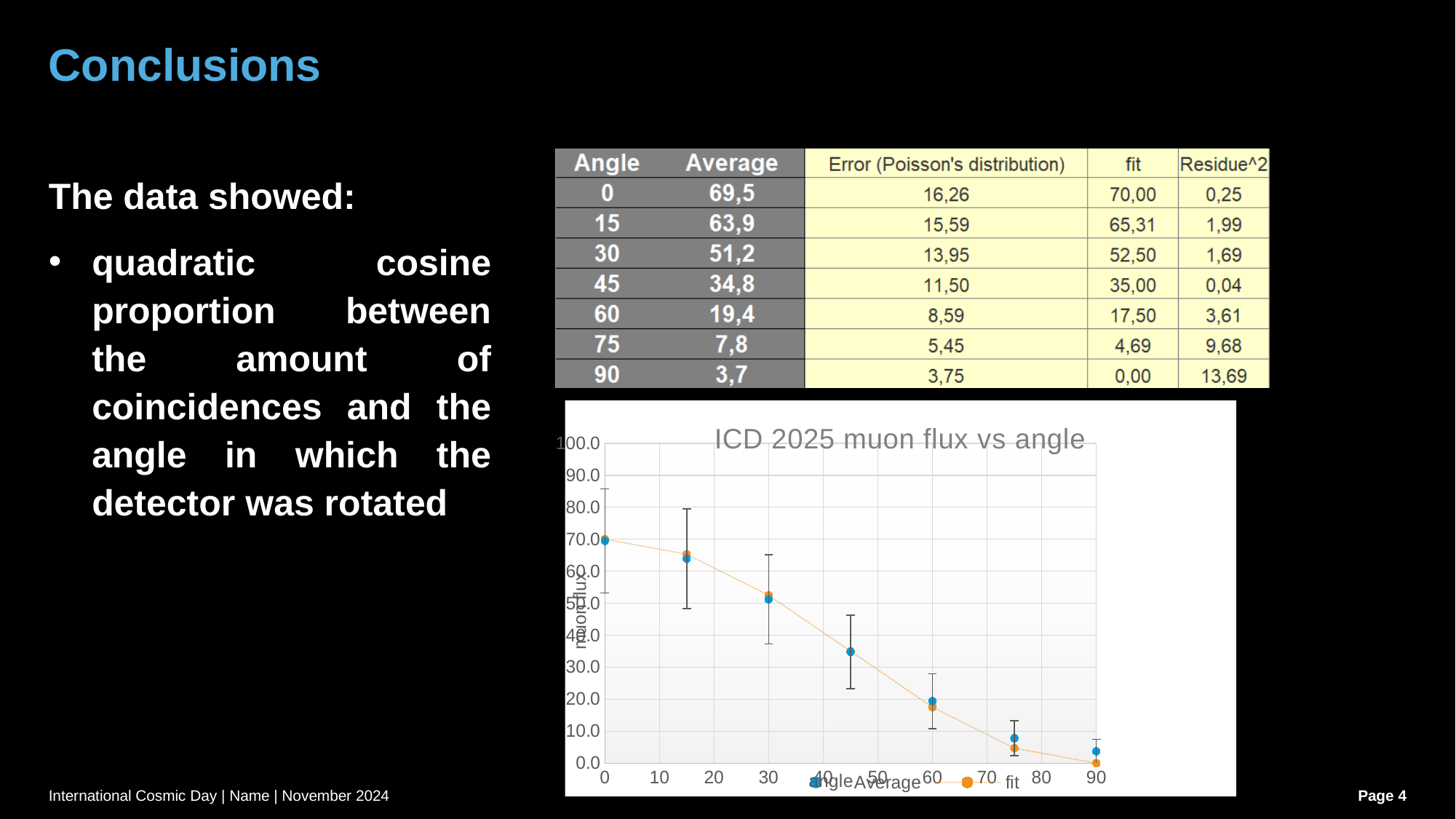
How many series does the chart legend list? 2 Which is larger, the Average value at angle 15 or at angle 60? angle 15 Is the Average value at angle 90 greater or less than 10.0? less What kind of chart is shown on the slide? scatter chart with a fitted line At which angle is the Average value lowest? 90 How many data points are plotted for the Average series? 7 What are the two series named in the chart legend? Average and fit Do the Average values rise or fall as the angle increases from 0 to 90? fall Is the Average value at angle 45 greater or less than 40.0? less What is the title of the chart? ICD 2025 muon flux vs angle At which angle is the Average value highest? 0 Is the Average value at angle 0 greater or less than 60.0? greater